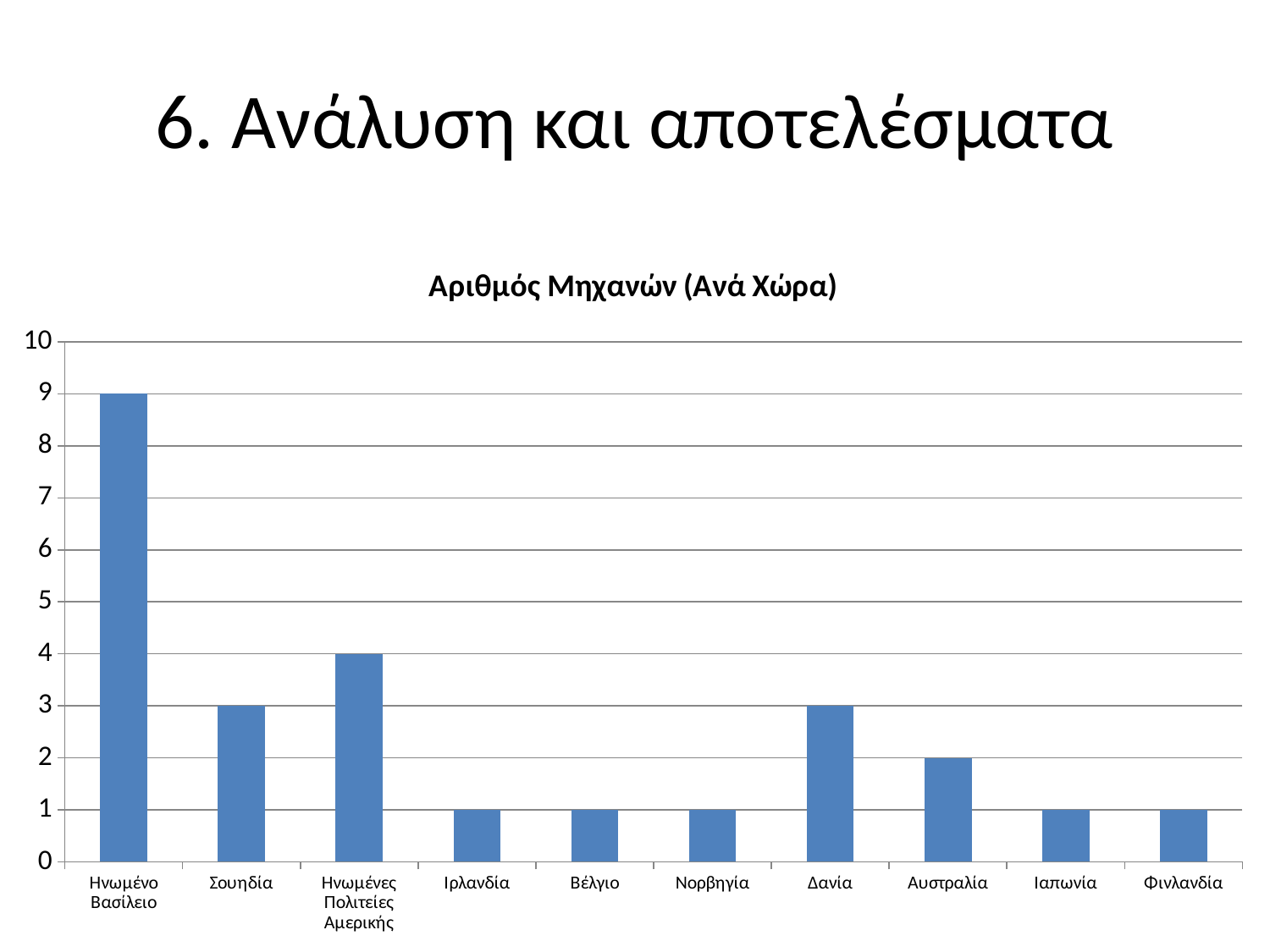
Which is larger, the value for Σουηδία or the value for Αυστραλία? Σουηδία Is the value for Ηνωμένο Βασίλειο greater or less than 5? greater What is the value for Ηνωμένες Πολιτείες Αμερικής? 4 What type of chart is shown on the slide? Bar chart What is the title of the chart? Αριθμός Μηχανών (Ανά Χώρα) What is the difference between the values for Ηνωμένο Βασίλειο and Ηνωμένες Πολιτείες Αμερικής? 5 What is the value for Δανία? 3 What is the value for Αυστραλία? 2 How many countries are shown on the x axis of the chart? 10 What is the value for Ηνωμένο Βασίλειο? 9 Which country has the highest value in the chart? Ηνωμένο Βασίλειο How many countries have a value of 1 in the chart? 5